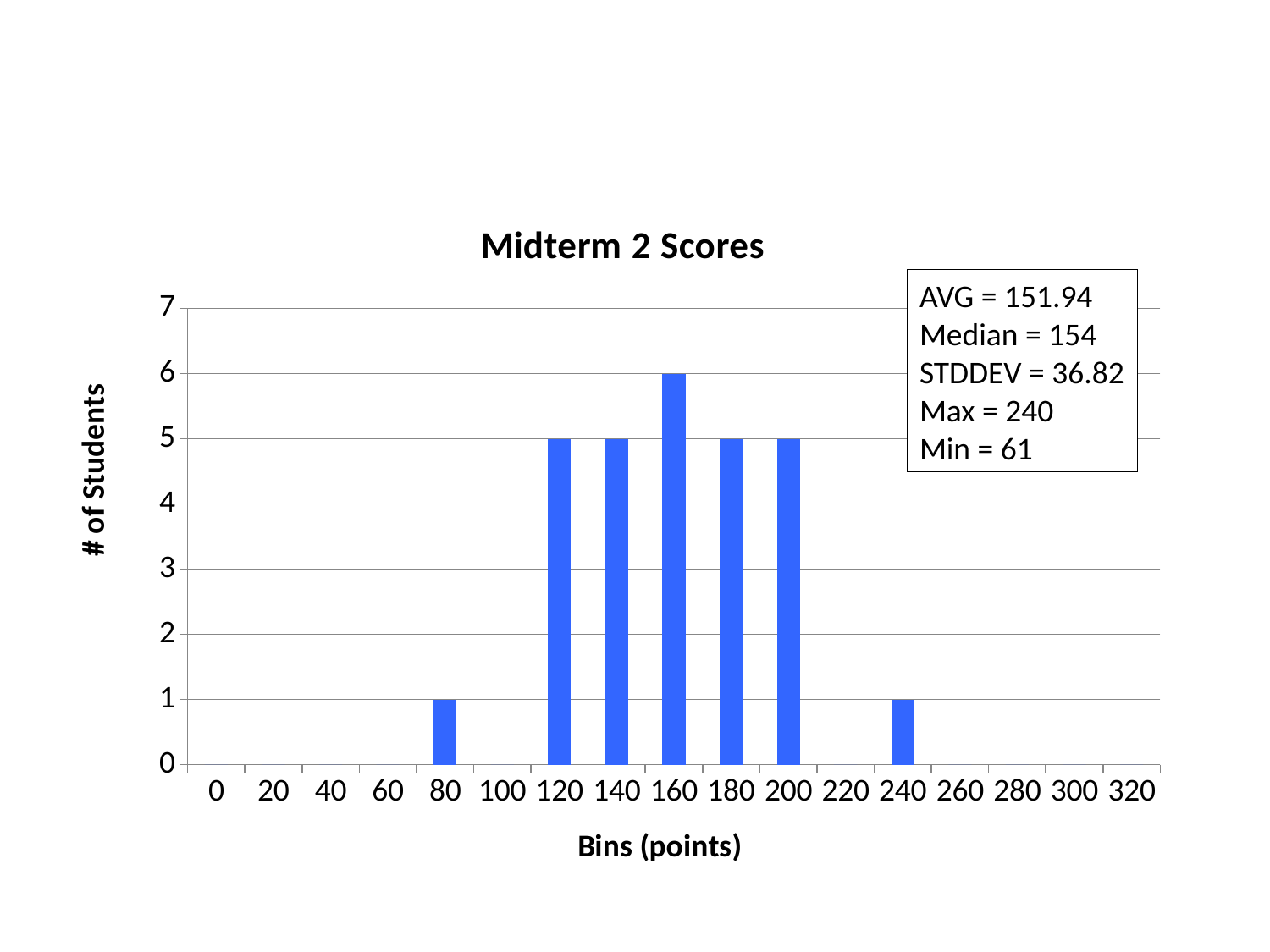
How many students are in the 80 bin? 1 How many students are in the 160 bin? 6 Which bin has the highest number of students? 160 Which bin has more students, 160 or 200? 160 What is the title of the chart? Midterm 2 Scores How many bins have a bar with at least one student? 7 Is the value for the 200 bin greater or less than 4? greater What is the difference in number of students between the 160 bin and the 180 bin? 1 How many students are in the 120 bin? 5 What type of chart is shown on the slide? bar chart How many students are in the 240 bin? 1 What is the label of the y axis? # of Students